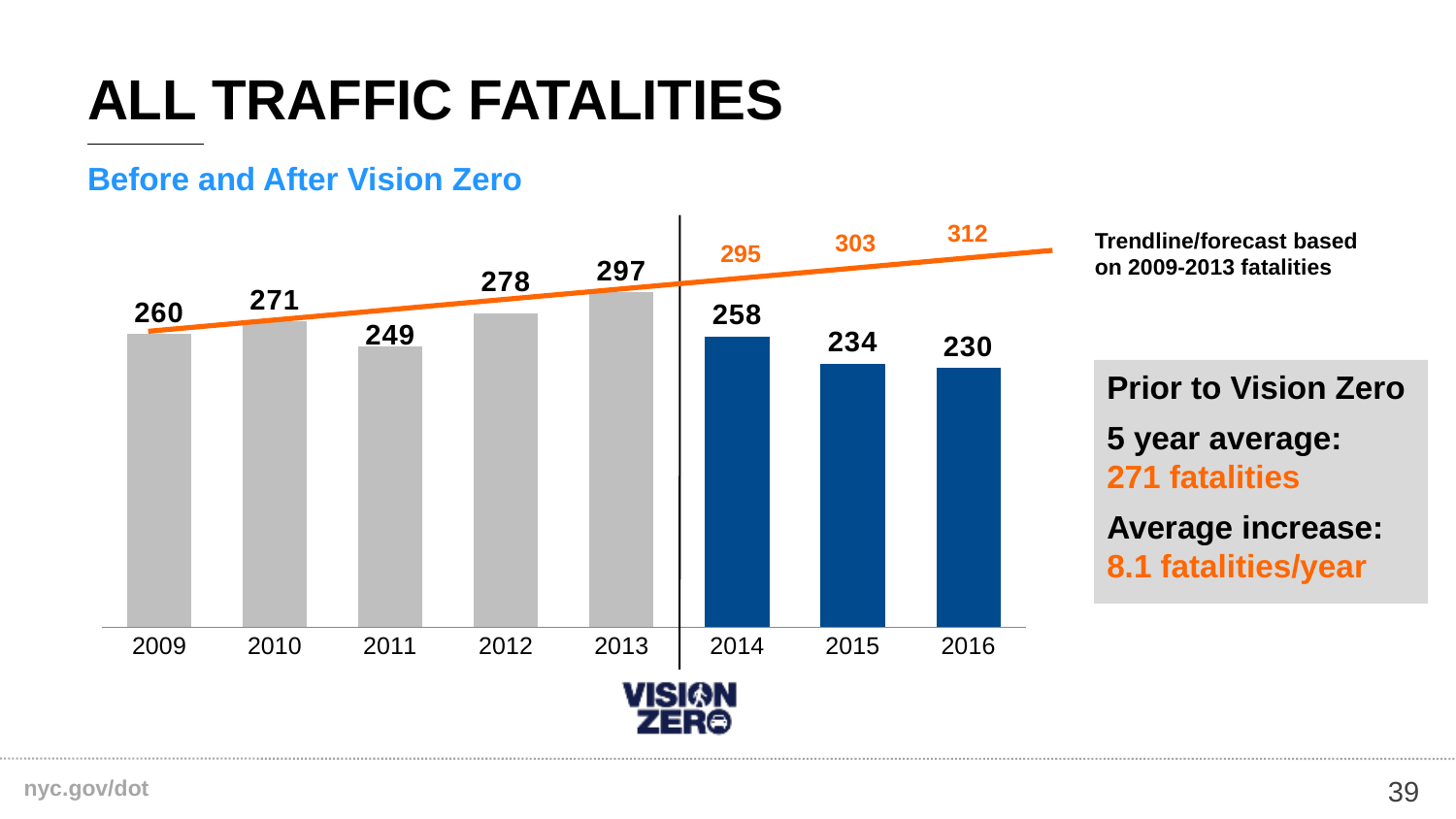
Do the fatality values rise or fall from 2014 to 2016? Fall What colour are the bars for the years 2014 to 2016? Blue What is the difference between the 2016 trendline forecast and the actual 2016 fatalities? 82 How many years are shown as bars in the chart? 8 What is the number of traffic fatalities shown for 2016? 230 What is the difference between the 2013 fatalities and the 2016 fatalities? 67 What kind of chart is used to show the traffic fatalities? Bar chart What is the number of traffic fatalities shown for 2013? 297 Which year had more traffic fatalities, 2011 or 2014? 2014 Which year has the highest number of traffic fatalities among the bars? 2013 What is the trendline forecast value shown for 2015? 303 Which year has the lowest number of traffic fatalities among the bars? 2016